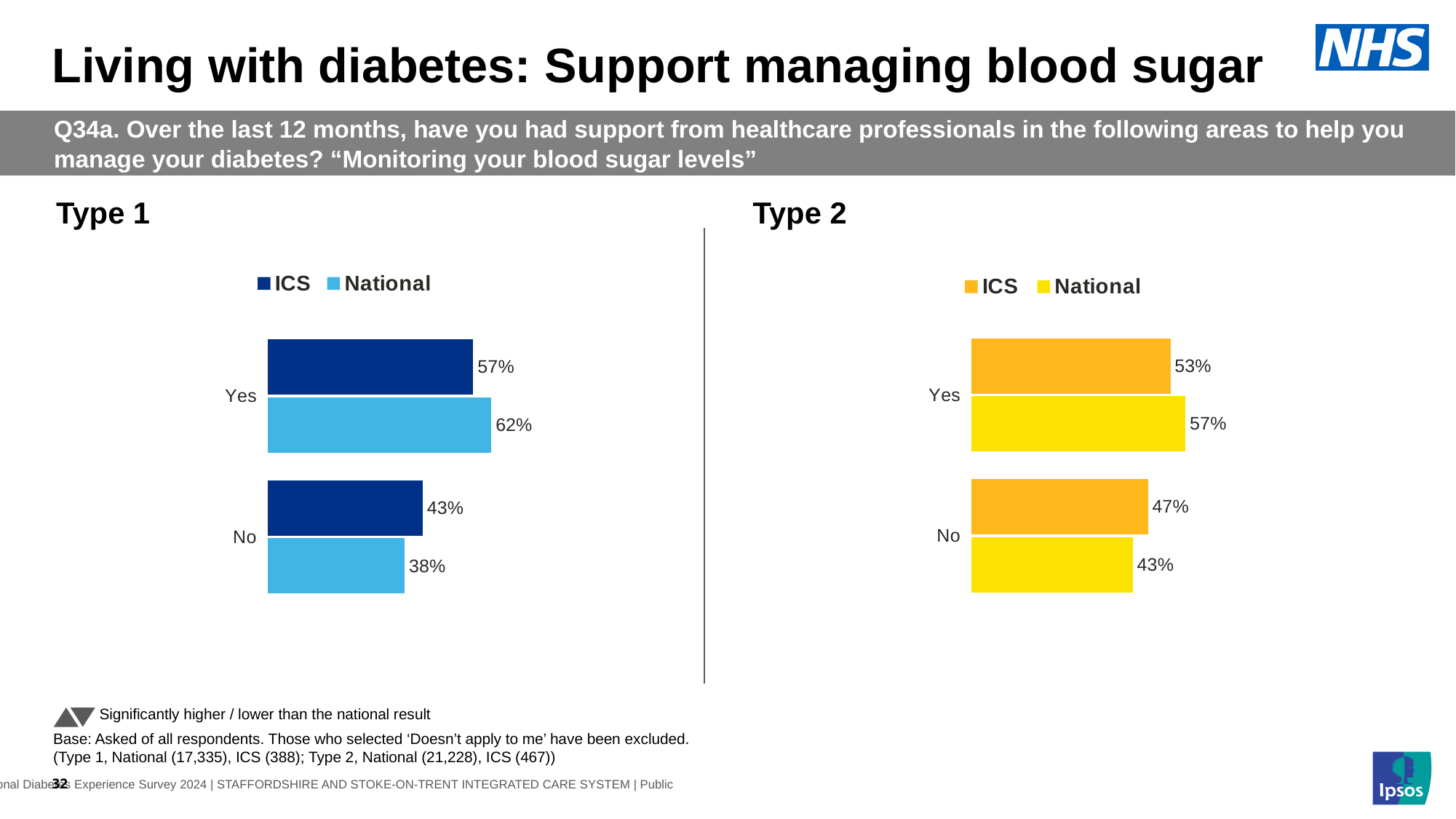
In the Type 2 chart, what is the ICS value for Yes? 53% In the Type 2 chart, what colour are the National bars? Yellow In the Type 1 chart, which is larger for No, ICS or National? ICS In the Type 1 chart, what is the ICS value for Yes? 57% In the Type 1 chart, what is the National value for No? 38% How many series does the legend of the Type 1 chart list? 2 In the Type 2 chart, what is the National value for No? 43% In the Type 2 chart, what is the difference between the ICS and National values for No? 4% How many categories are shown in the Type 2 chart? 2 In the Type 1 chart, what is the difference between the National and ICS values for Yes? 5% What kind of chart is the Type 1 chart? Bar chart In the Type 2 chart, which is larger for Yes, ICS or National? National